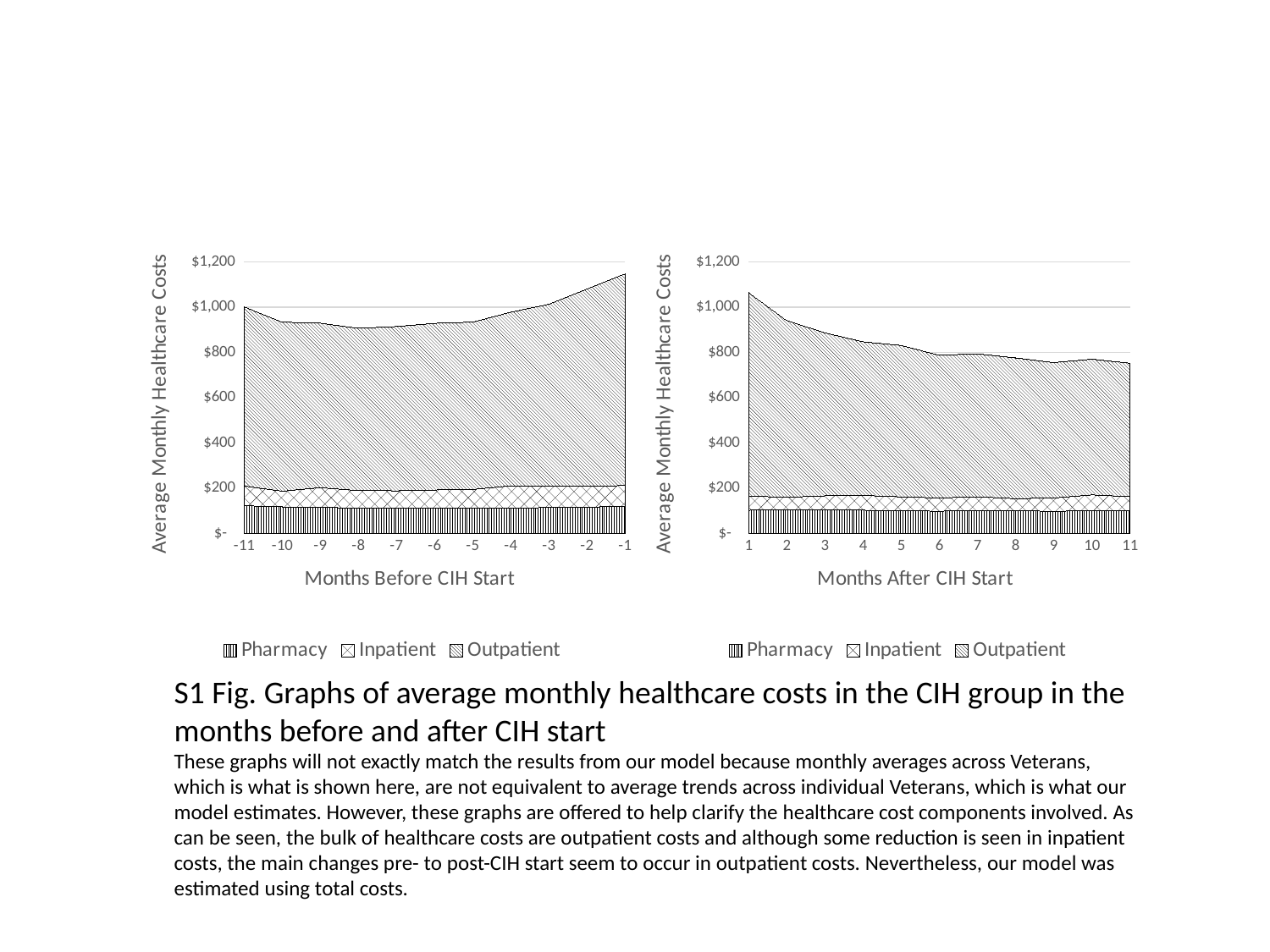
How many months are plotted on the x axis of the 'Months Before CIH Start' chart? 11 What is the y-axis title of the 'Months Before CIH Start' chart? Average Monthly Healthcare Costs In the 'Months After CIH Start' chart, do total average monthly healthcare costs rise or fall from month 1 to month 11? fall What kind of chart is the 'Months Before CIH Start' chart? stacked area chart How many series does the legend of the 'Months After CIH Start' chart list? 3 In the 'Months Before CIH Start' chart, is the total cost at month -1 greater or less than $1,000? greater In the 'Months After CIH Start' chart, which month has the highest total average monthly healthcare cost? 1 In the 'Months Before CIH Start' chart, which month has the highest total average monthly healthcare cost? -1 In the 'Months Before CIH Start' chart, is the total cost at month -8 greater or less than $1,000? less In the 'Months After CIH Start' chart, is the total cost at month 11 greater or less than $800? less In the 'Months After CIH Start' chart, which series accounts for the largest share of costs? Outpatient In the 'Months Before CIH Start' chart, do total average monthly healthcare costs rise or fall from month -5 to month -1? rise